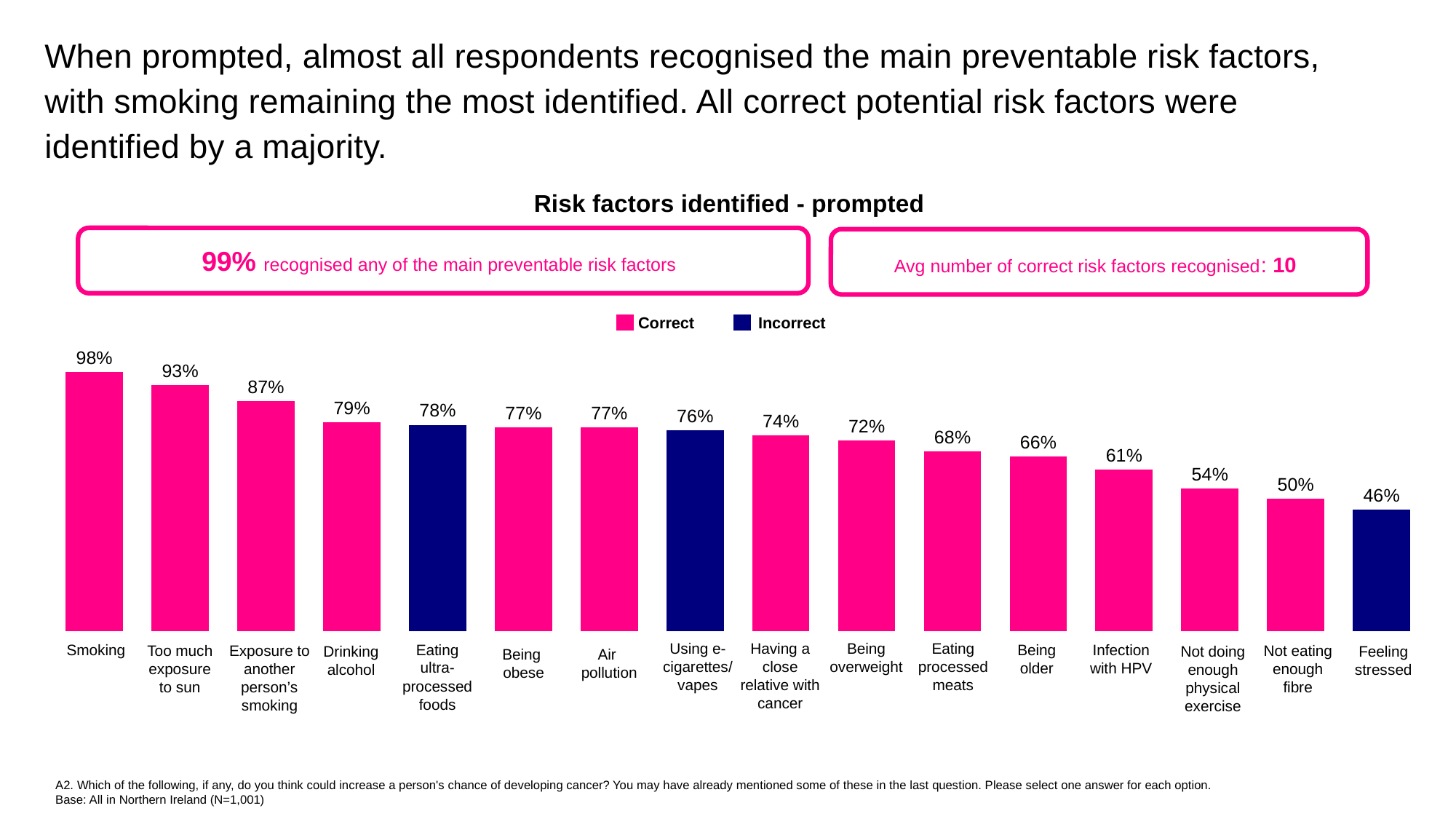
Which has a higher value, Being overweight or Eating processed meats? Being overweight Which colour is used for the Incorrect bars in the chart? Dark blue What kind of chart is shown on the slide? Bar chart What is the difference between the values for Smoking and Feeling stressed? 52% What is the value shown for Infection with HPV? 61% Which risk factor has the highest value in the chart? Smoking What percentage of respondents identified Smoking as a risk factor? 98% Which risk factor has the lowest value in the chart? Feeling stressed What is the value shown for Eating ultra-processed foods? 78% How many series does the legend list? 2 How many risk factors (bars) are shown in the chart? 16 What is the difference between the values for Drinking alcohol and Being older? 13%